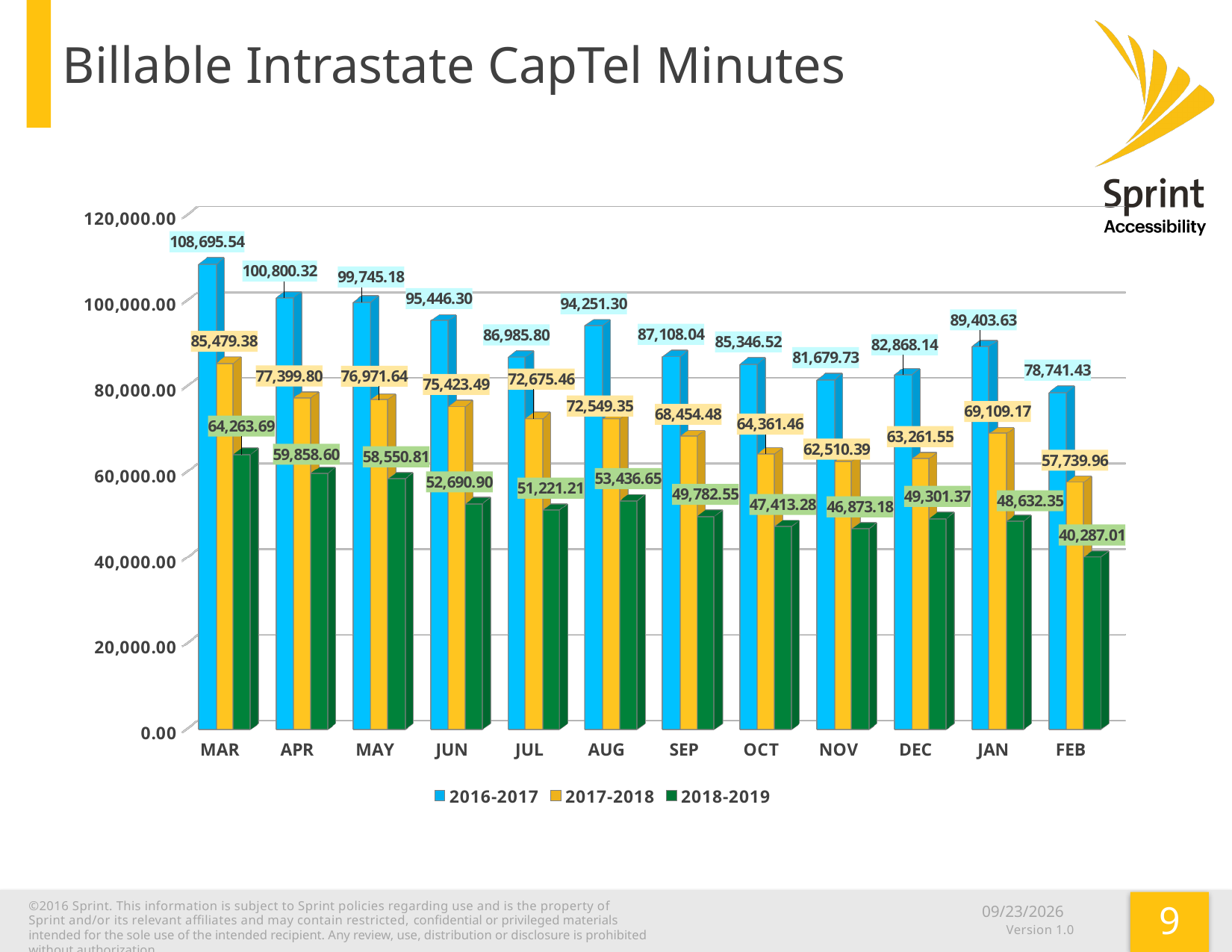
What type of chart is shown on the slide? bar chart What is the difference between the 2016-2017 and 2018-2019 values in MAR? 44,431.85 Which month has the highest value for the 2016-2017 series? MAR What is the value for 2018-2019 in JAN? 48,632.35 How many series does the legend list? 3 What is the value for 2016-2017 in MAR? 108,695.54 What is the title of the chart? Billable Intrastate CapTel Minutes Which is larger in AUG: the 2016-2017 value or the 2017-2018 value? 2016-2017 How many months are shown on the x axis? 12 What is the value for 2017-2018 in OCT? 64,361.46 What is the difference between the 2017-2018 and 2018-2019 values in FEB? 17,452.95 Which month has the lowest value for the 2018-2019 series? FEB